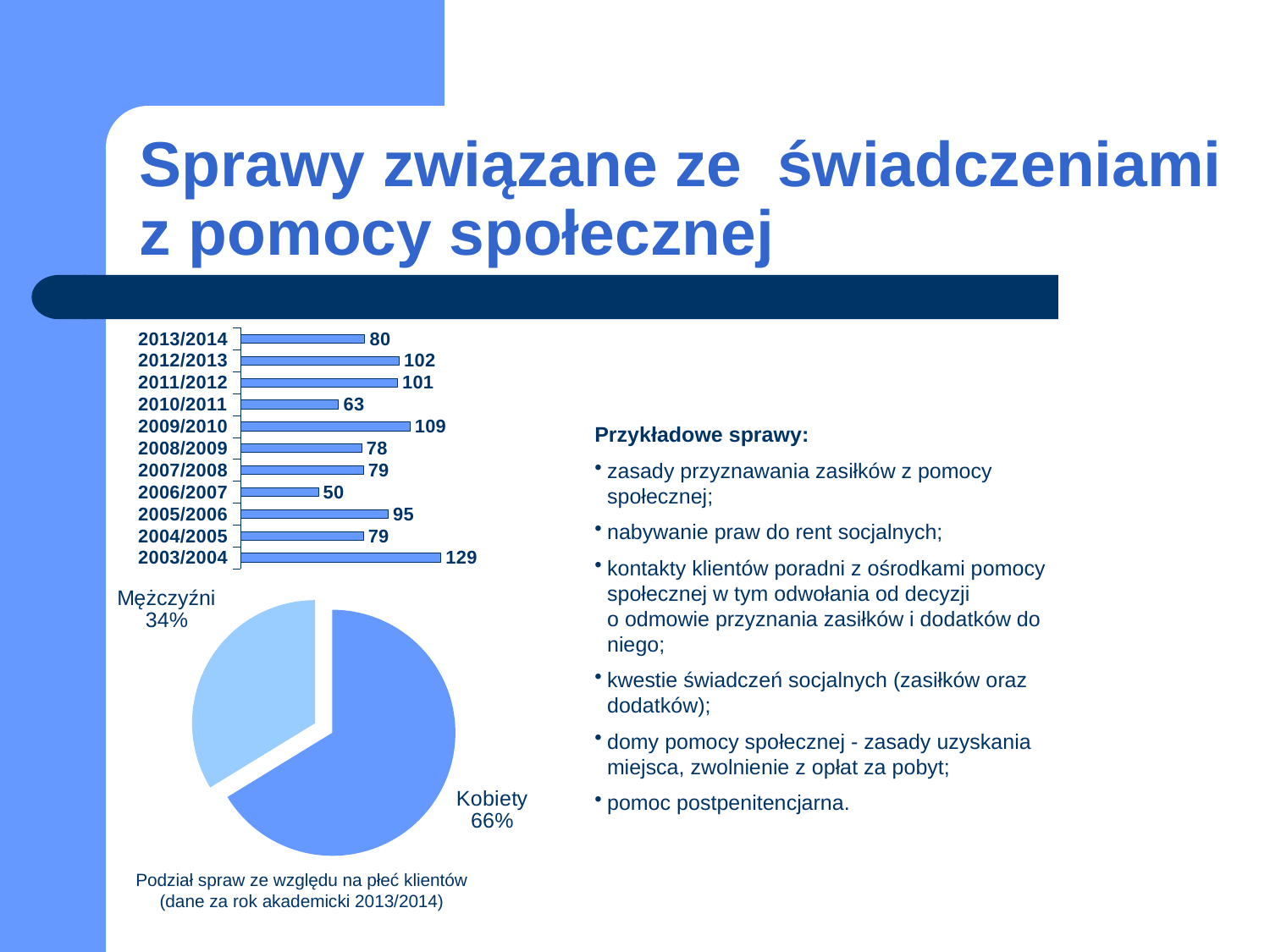
In the pie chart 'Podział spraw ze względu na płeć klientów', what share is Kobiety? 66% How many academic years are shown in the bar chart at the top left? 11 In the bar chart at the top left, what is the value for 2003/2004? 129 What kind of chart is the chart at the top left of the slide? bar chart In the bar chart at the top left, which academic year has the highest value? 2003/2004 How many slices does the pie chart 'Podział spraw ze względu na płeć klientów' have? 2 In the bar chart at the top left, which academic year has the lowest value? 2006/2007 In the bar chart at the top left, what is the value for 2013/2014? 80 In the bar chart at the top left, what is the difference between the values for 2012/2013 and 2010/2011? 39 In the bar chart at the top left, which is larger, the value for 2005/2006 or the value for 2008/2009? 2005/2006 In the pie chart 'Podział spraw ze względu na płeć klientów', what share is Mężczyźni? 34% In the bar chart at the top left, what is the value for 2009/2010? 109